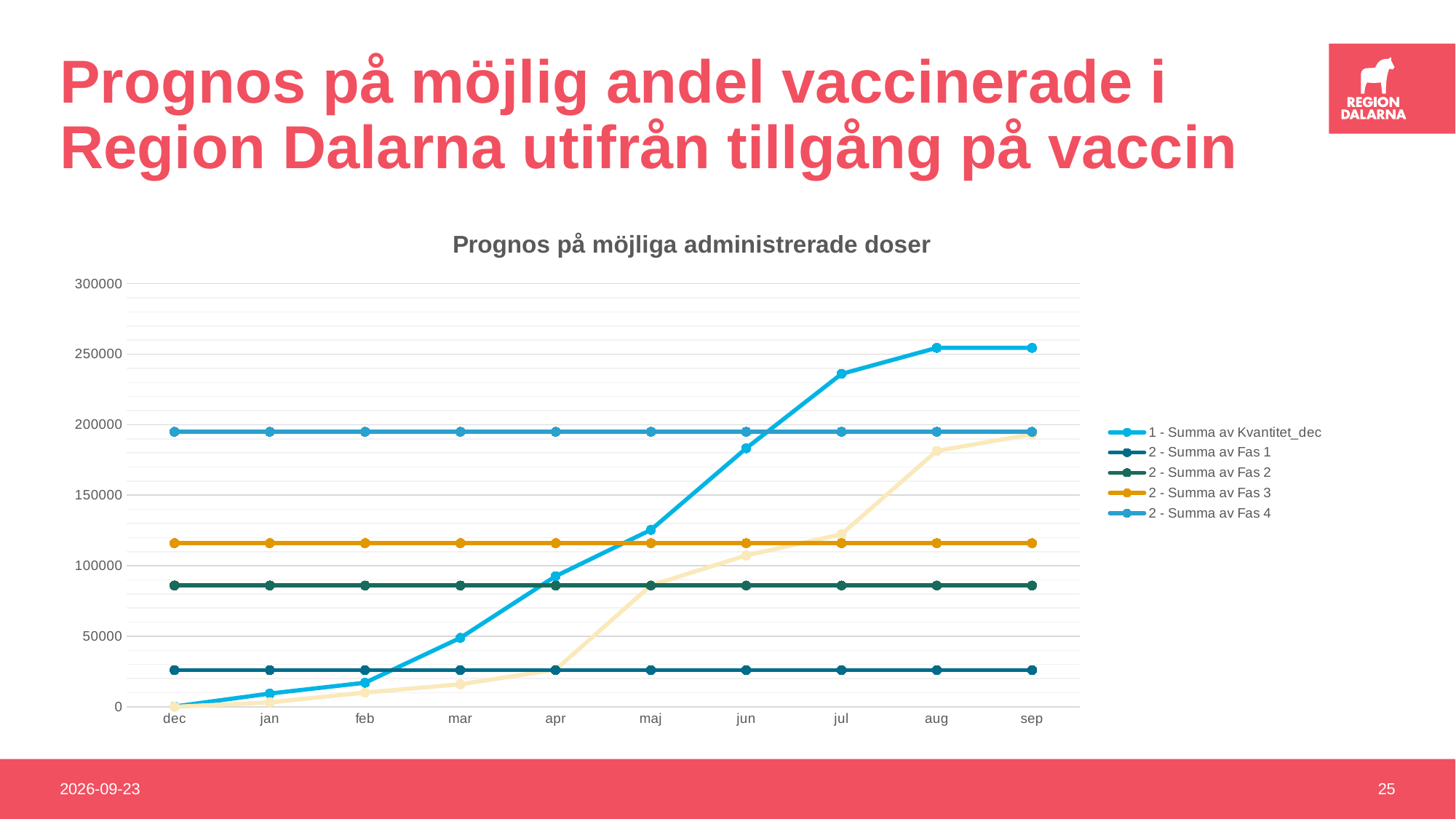
Is the value for '1 - Summa av Kvantitet_dec' in mar greater or less than 100000? less How many series does the legend list? 5 How many months are shown on the x axis? 10 Is the value for '2 - Summa av Fas 4' greater or less than 150000? greater What kind of chart is shown on the slide? line chart Is the value for '1 - Summa av Kvantitet_dec' in jul greater or less than 200000? greater Which series has the highest value in sep? 1 - Summa av Kvantitet_dec Does the series '1 - Summa av Kvantitet_dec' rise or fall from dec to sep? rise What is the title of the chart? Prognos på möjliga administrerade doser Does the series '2 - Summa av Fas 4' rise, fall or stay flat across the months? stays flat In jan, which is larger: '2 - Summa av Fas 4' or '1 - Summa av Kvantitet_dec'? 2 - Summa av Fas 4